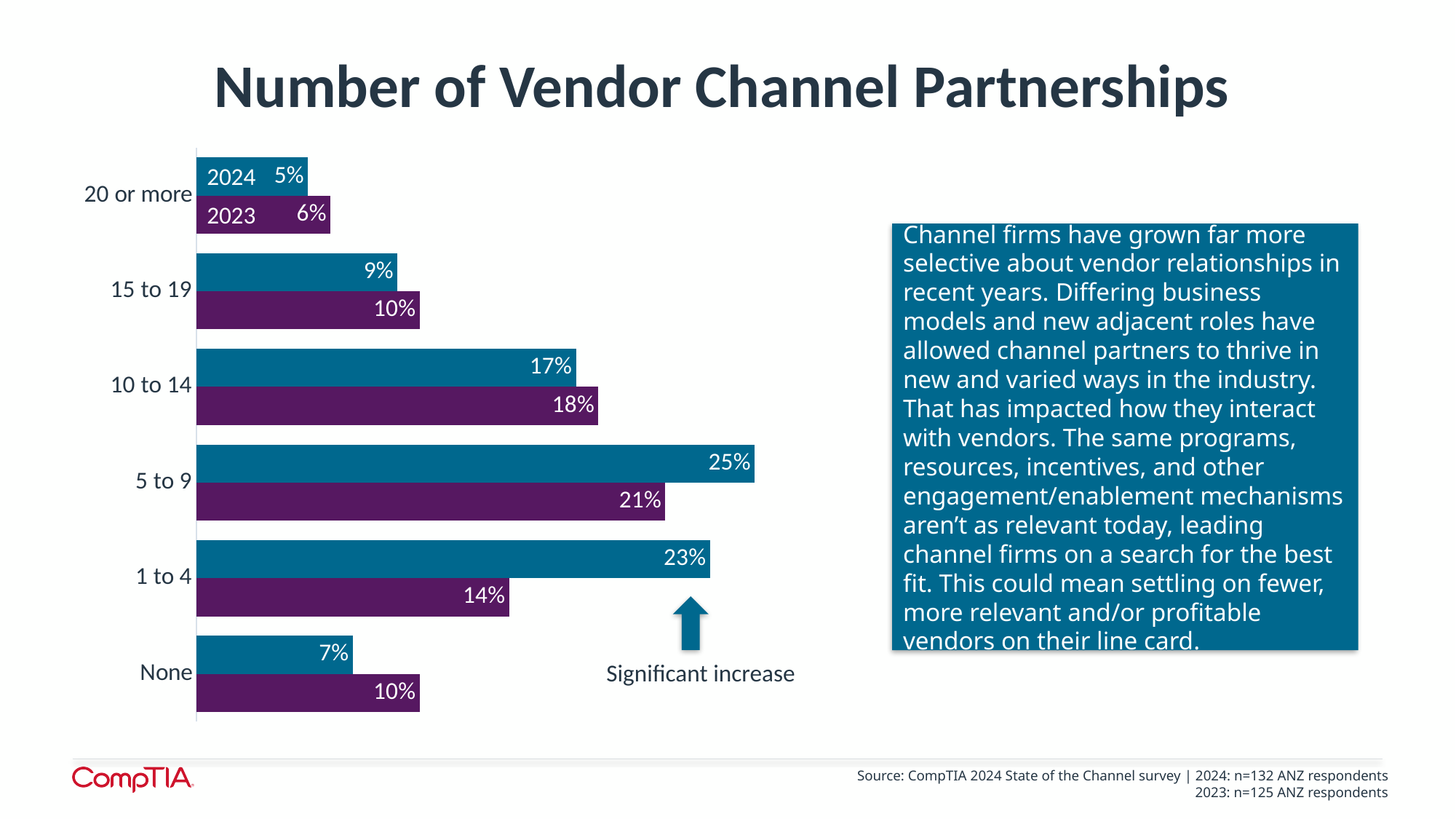
How many series does the chart show? 2 What is the difference between the 2024 and 2023 values for '1 to 4'? 9% What is the title of the chart? Number of Vendor Channel Partnerships What is the 2024 value for the '5 to 9' category? 25% Which category is marked with the 'Significant increase' arrow? 1 to 4 What is the 2024 value for 'None'? 7% Which is larger for '10 to 14': the 2024 value or the 2023 value? 2023 Which category has the lowest 2023 value? 20 or more Which category has the highest 2024 value? 5 to 9 What is the 2023 value for the '1 to 4' category? 14% How many categories are shown on the chart? 6 What kind of chart is shown on the slide? Bar chart